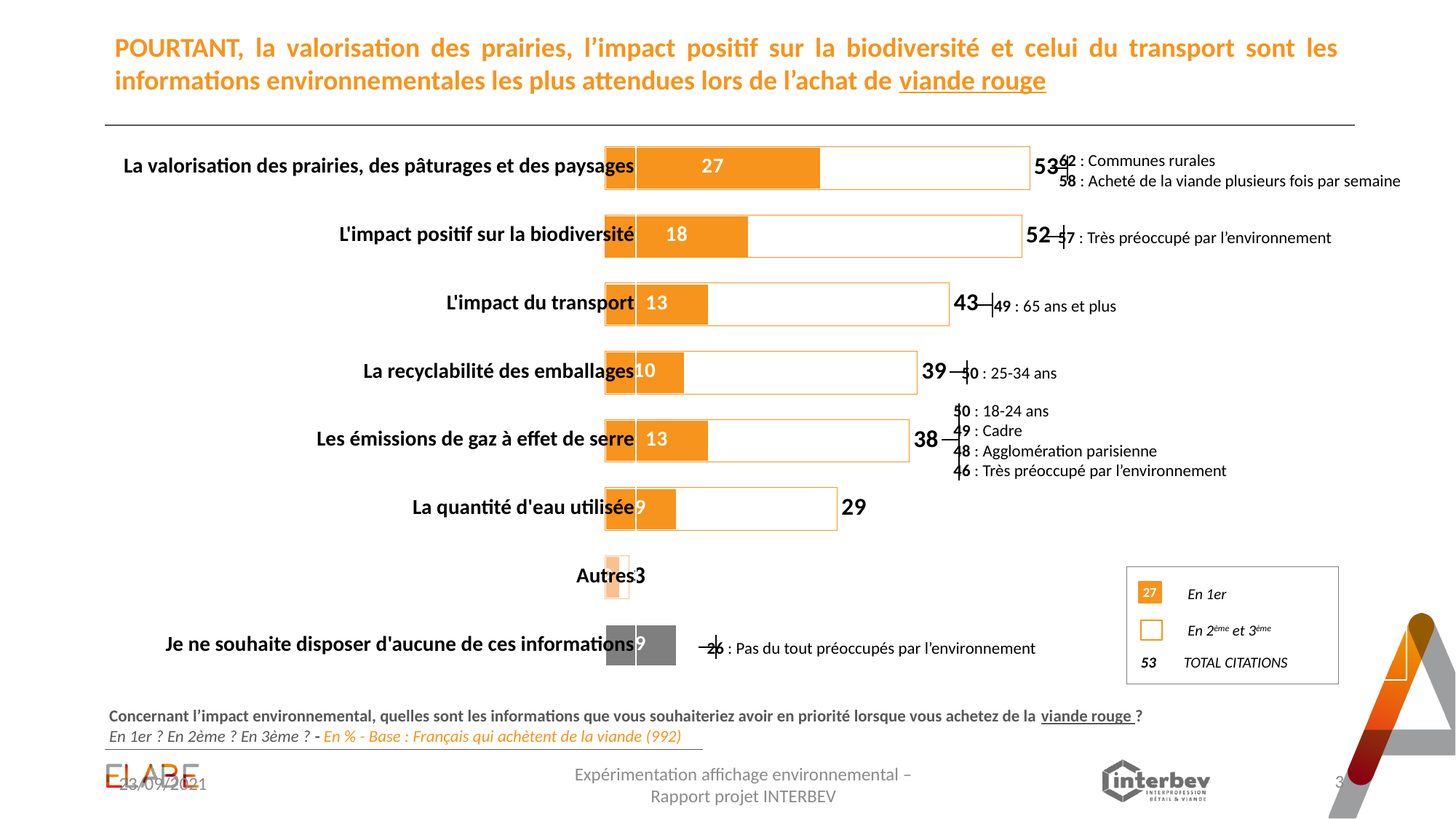
Which category has the lowest 'En 1er' value? Autres Which category has the highest 'En 1er' value? La valorisation des prairies, des pâturages et des paysages Which has a higher total citations value: 'L'impact du transport' or 'Les émissions de gaz à effet de serre'? L'impact du transport What is the difference between the 'En 1er' values for 'La valorisation des prairies, des pâturages et des paysages' and 'L'impact du transport'? 14 How many categories are shown in the chart? 8 What is the total citations value for 'L'impact du transport'? 43 What is the 'En 1er' value for 'La valorisation des prairies, des pâturages et des paysages'? 27 What is the total citations value for 'L'impact positif sur la biodiversité'? 52 What is the 'En 1er' value for 'Je ne souhaite disposer d'aucune de ces informations'? 9 What kind of chart is shown on the slide? Bar chart What is the difference between the total citations for 'La valorisation des prairies, des pâturages et des paysages' and 'L'impact positif sur la biodiversité'? 1 Among the categories with a total citations value shown, which has the lowest total? Autres